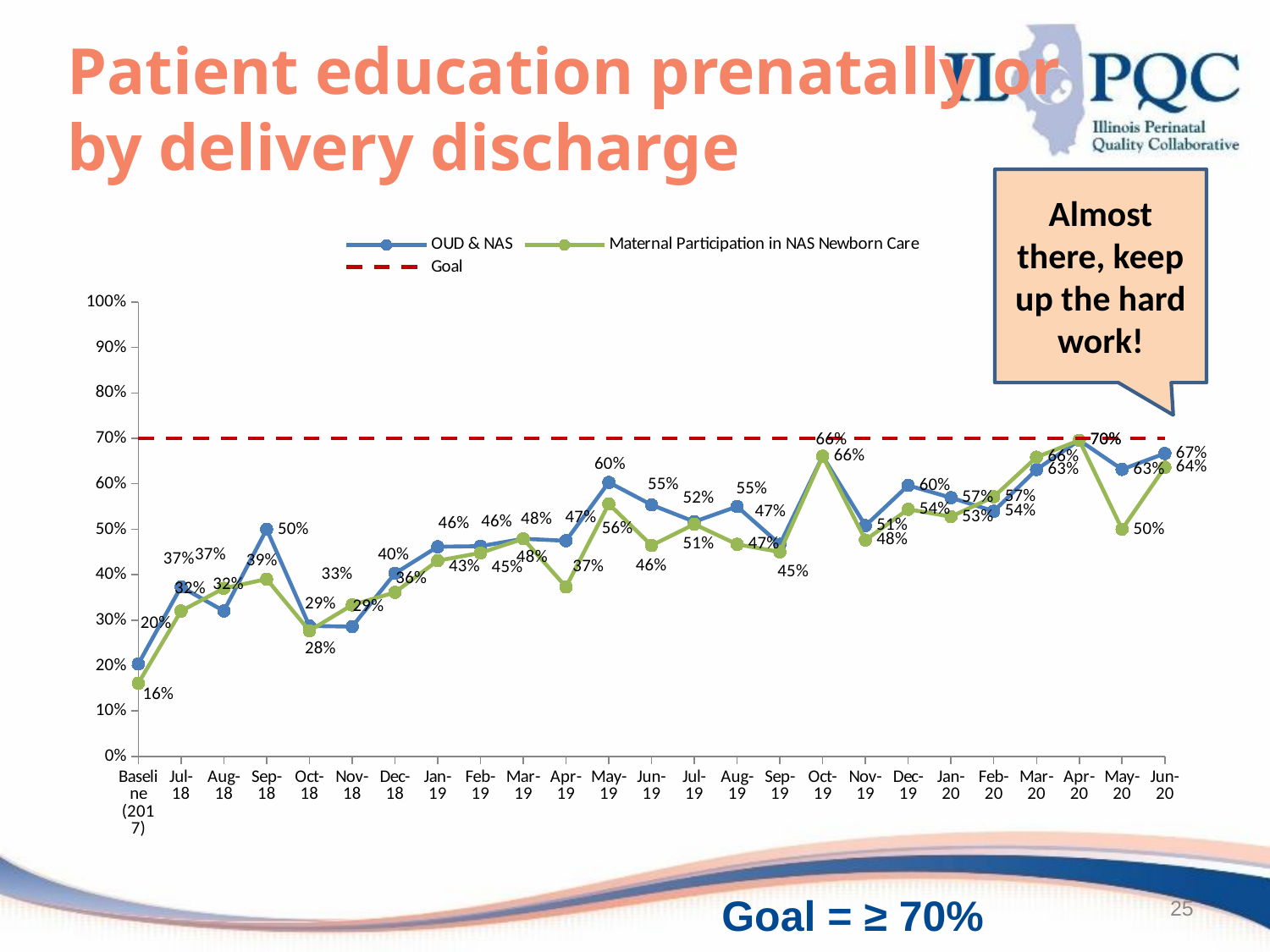
At what value is the dashed Goal line drawn? 70% How many series does the legend list? 3 Overall, does the OUD & NAS series rise or fall from Baseline (2017) to Jun-20? Rise In which month does the OUD & NAS series reach its highest value? Apr-20 What is the Maternal Participation in NAS Newborn Care value at Baseline (2017)? 16% At which point is the Maternal Participation in NAS Newborn Care series lowest? Baseline (2017) What is the OUD & NAS value for Jun-20? 67% For May-20, which series has the higher value, OUD & NAS or Maternal Participation in NAS Newborn Care? OUD & NAS What is the difference between the OUD & NAS and Maternal Participation in NAS Newborn Care values for Jun-20? 3 percentage points What is the Maternal Participation in NAS Newborn Care value for Jun-20? 64% What kind of chart is shown on the slide? Line chart What is the OUD & NAS value for May-19? 60%